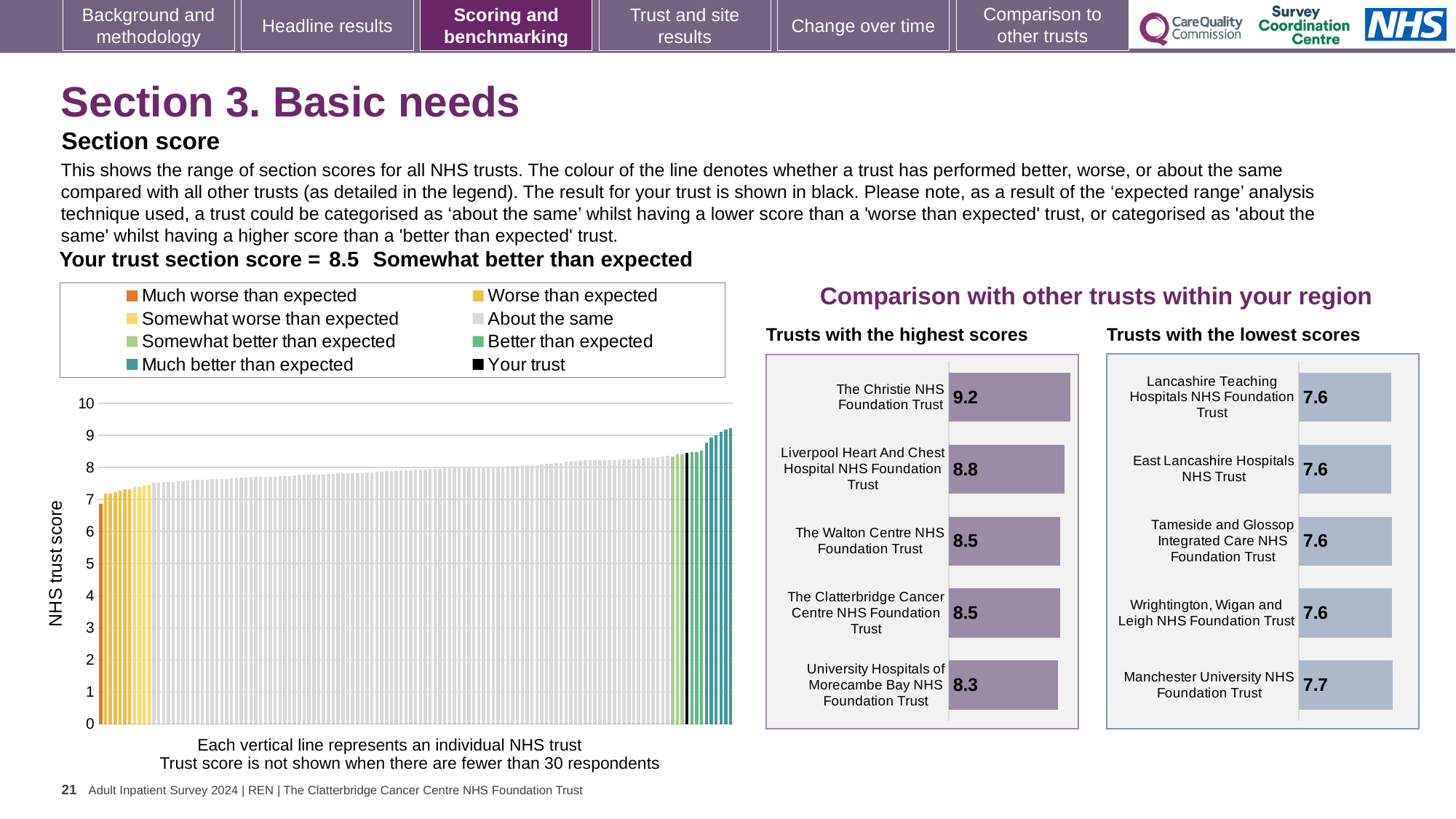
What kind of chart is the large chart on the left showing all NHS trusts? bar chart In the large chart on the left showing all NHS trusts, do the bar values rise or fall from left to right? rise How many trusts are shown in the 'Trusts with the highest scores' chart? 5 In the 'Trusts with the highest scores' chart, which has the higher score: Liverpool Heart And Chest Hospital NHS Foundation Trust or The Walton Centre NHS Foundation Trust? Liverpool Heart And Chest Hospital NHS Foundation Trust In the 'Trusts with the lowest scores' chart, what is the score for Manchester University NHS Foundation Trust? 7.7 In the 'Trusts with the highest scores' chart, what is the difference between the scores of The Christie NHS Foundation Trust and University Hospitals of Morecambe Bay NHS Foundation Trust? 0.9 In the 'Trusts with the lowest scores' chart, which trust has the highest score? Manchester University NHS Foundation Trust In the 'Trusts with the highest scores' chart, which trust has the lowest score? University Hospitals of Morecambe Bay NHS Foundation Trust In the 'Trusts with the highest scores' chart, what is the score for The Christie NHS Foundation Trust? 9.2 In the large chart on the left showing all NHS trusts, is the value of the tallest bar greater or less than 9? greater In the 'Trusts with the lowest scores' chart, what is the difference between the scores of Manchester University NHS Foundation Trust and East Lancashire Hospitals NHS Trust? 0.1 How many entries does the legend of the large chart on the left list? 8